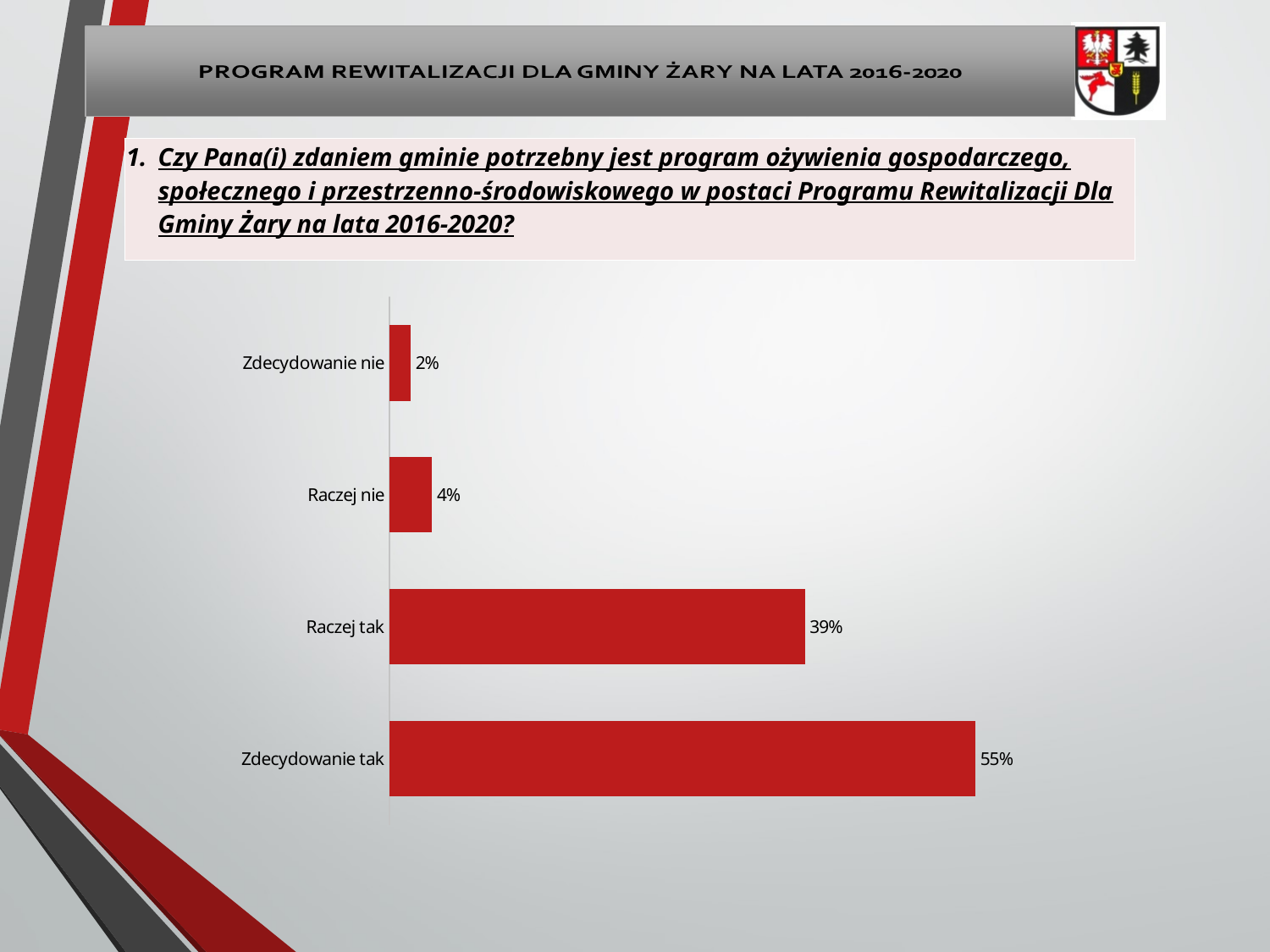
How many categories are shown in the chart? 4 What kind of chart is shown on the slide? Bar chart What colour are the bars in the chart? Red What is the value for "Zdecydowanie nie"? 2% Which is larger, the value for "Raczej tak" or the value for "Raczej nie"? Raczej tak What is the value for "Raczej nie"? 4% What is the value for "Zdecydowanie tak"? 55% What is the difference between the values for "Raczej nie" and "Zdecydowanie nie"? 2% What is the value for "Raczej tak"? 39% What is the difference between the values for "Zdecydowanie tak" and "Raczej tak"? 16% Which category has the lowest value? Zdecydowanie nie Which category has the highest value? Zdecydowanie tak